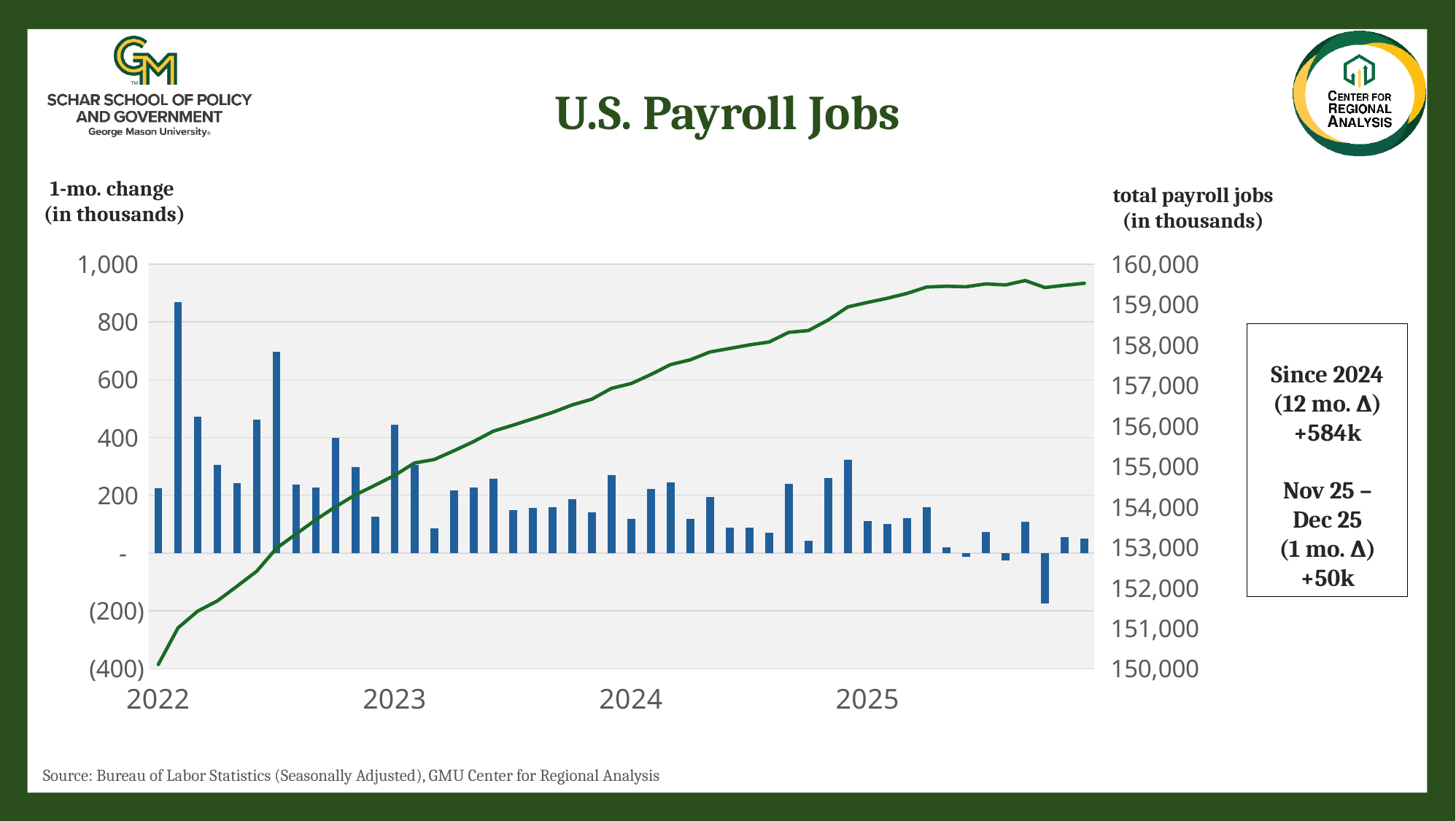
What is the 12-month change in payroll jobs since 2024 shown in the text box? +584k In which year does the lowest (most negative) 1-month change bar occur? 2025 Is the total payroll jobs value at the start of 2022 greater or less than 151,000? less Is the tallest 1-month change bar, in early 2022, greater or less than 800? greater What does the left axis of the chart measure? 1-mo. change (in thousands) What is the title of the chart? U.S. Payroll Jobs Is the total payroll jobs value at the end of 2025 greater or less than 158,000? greater Does the total payroll jobs line rise or fall from 2022 to 2025? Rise What kind of chart is shown on the slide? Combined bar and line chart What is the 1-month change from Nov 25 to Dec 25 shown in the text box? +50k In which year does the tallest 1-month change bar occur? 2022